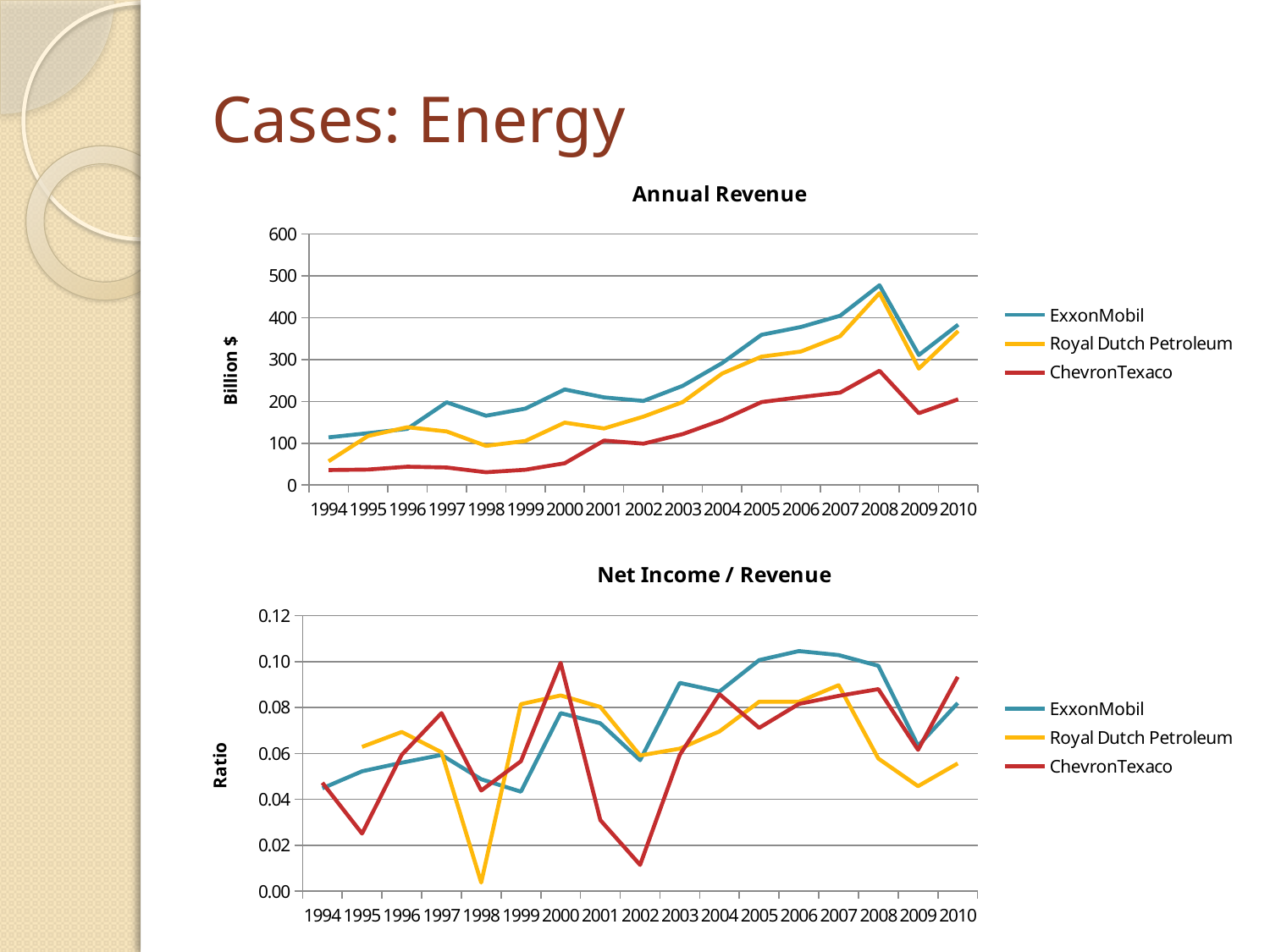
In the Annual Revenue chart, does ExxonMobil's revenue generally rise or fall from 1994 to 2008? Rise In the Annual Revenue chart, is the value for ChevronTexaco in 1994 greater or less than 100? less What kind of chart is the Annual Revenue chart? Line chart In the Net Income / Revenue chart, is the value for ChevronTexaco in 2002 greater or less than 0.02? less In the Net Income / Revenue chart, which company has the highest ratio in 2000? ChevronTexaco How many years are shown on the x axis of the Annual Revenue chart? 17 In the Annual Revenue chart, which company has the lowest revenue in 2010? ChevronTexaco In the Net Income / Revenue chart, which company has the lowest ratio in 1998? Royal Dutch Petroleum In the Annual Revenue chart, is the value for ExxonMobil in 2008 greater or less than 400? greater In the Annual Revenue chart, in which year does ExxonMobil's revenue peak? 2008 What is the y-axis label of the Annual Revenue chart? Billion $ How many series does the legend of the Annual Revenue chart list? 3